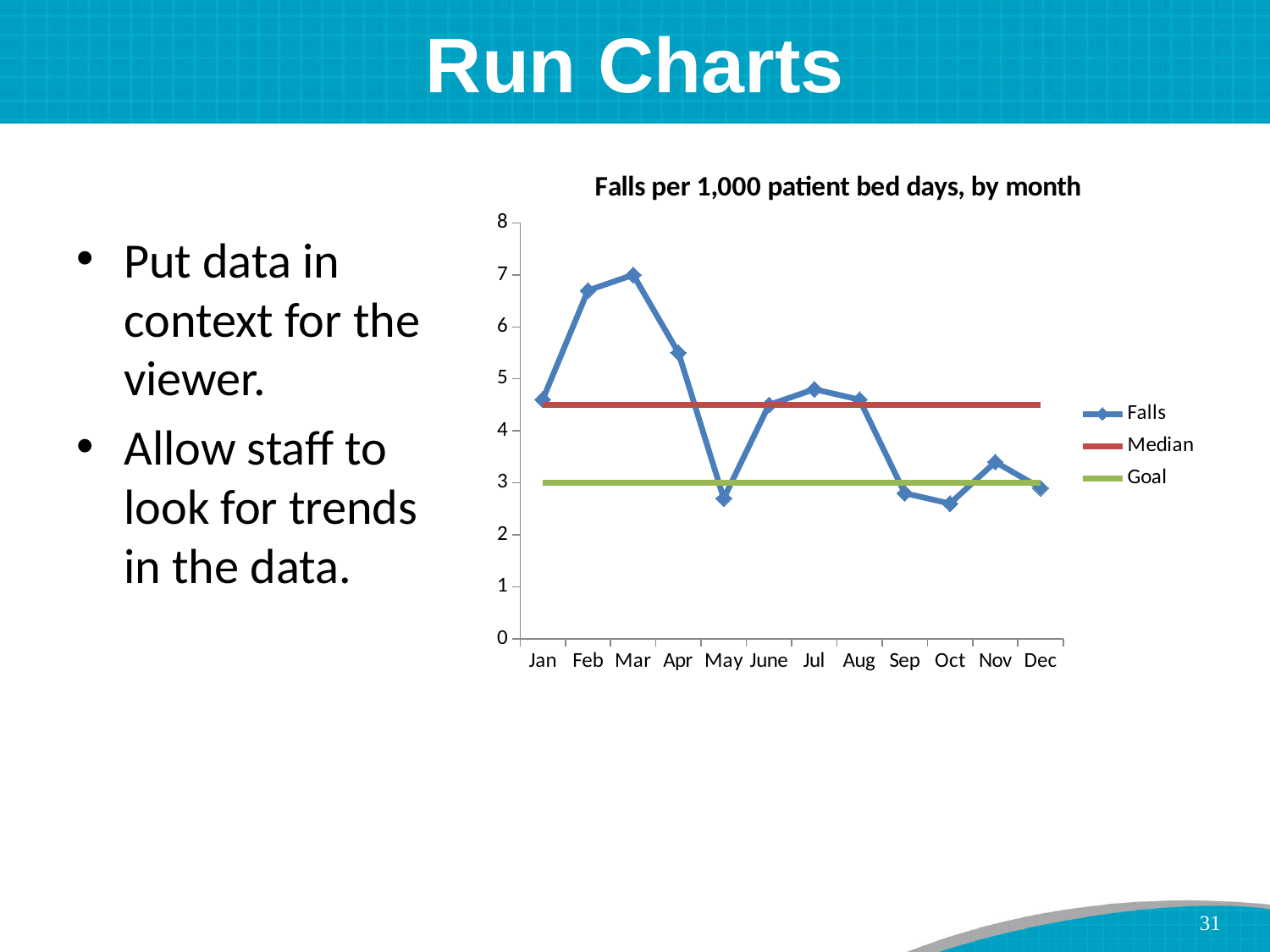
What is the title of the chart? Falls per 1,000 patient bed days, by month Do the Falls values rise or fall from Mar to May? fall Is the Falls value for Oct greater or less than 3? less Which month has a higher Falls value, Feb or Sep? Feb How many series does the legend list? 3 In which month is the Falls value lowest? Oct What kind of chart is shown on the slide? line chart Is the Falls value for Feb greater or less than 6? greater Is the Falls value for Apr greater or less than 5? greater What value does the Goal line sit at? 3 In which month is the Falls value highest? Mar How many months are plotted along the x axis? 12